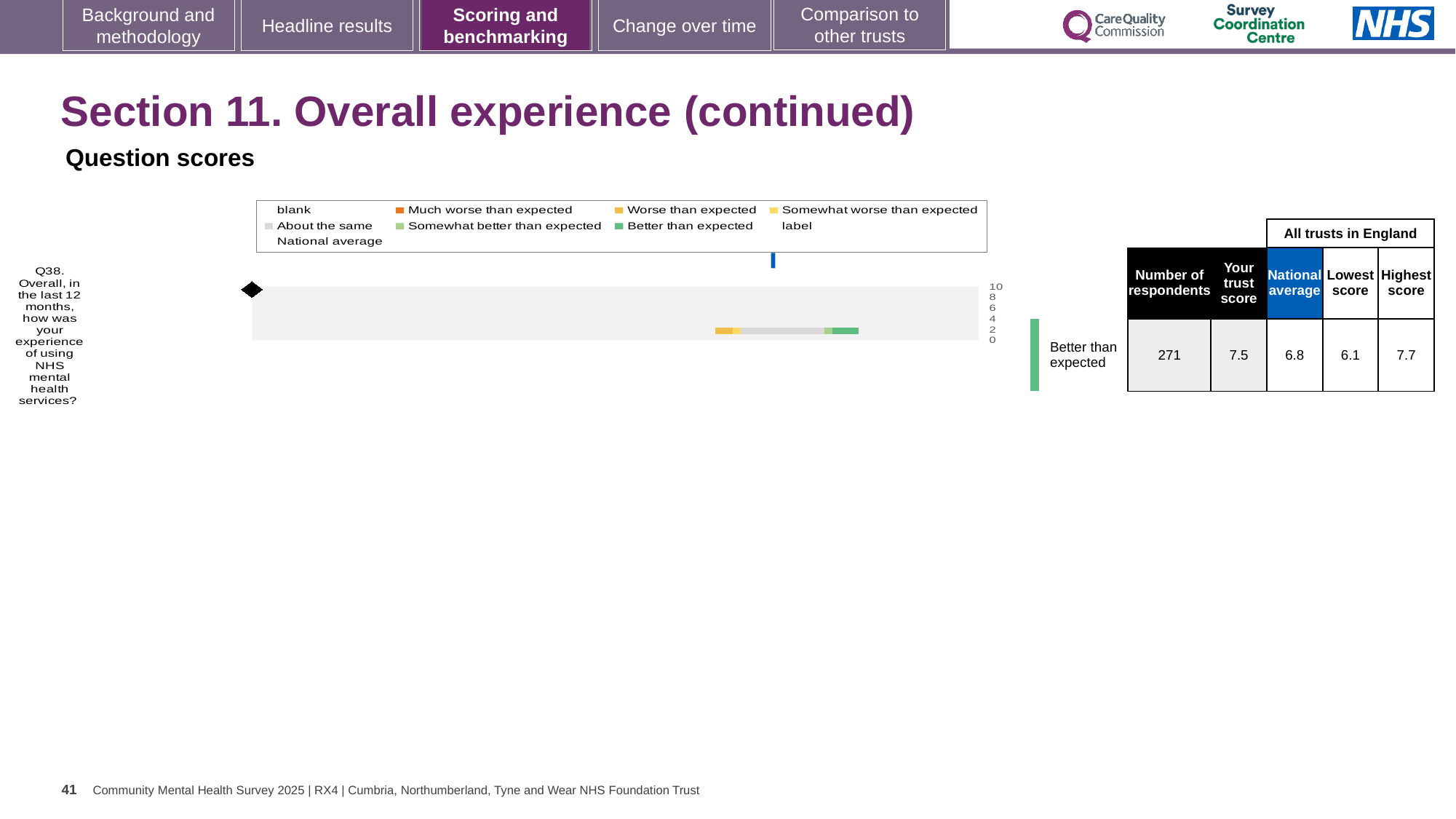
Which colour in the legend represents 'Much worse than expected'? orange What is the difference between the trust score and the national average for Q38? 0.7 What is the highest score among all trusts in England for Q38? 7.7 How many survey questions are plotted on the chart? 1 What is the trust score for Q38? 7.5 Which colour in the legend represents 'Better than expected'? green What is the lowest score among all trusts in England for Q38? 6.1 Which benchmarking category is Q38 placed in? Better than expected How many respondents answered Q38? 271 What kind of chart is used to show the Q38 question score? bar chart What is the national average score for Q38? 6.8 Which is larger for Q38, the trust score or the national average? trust score